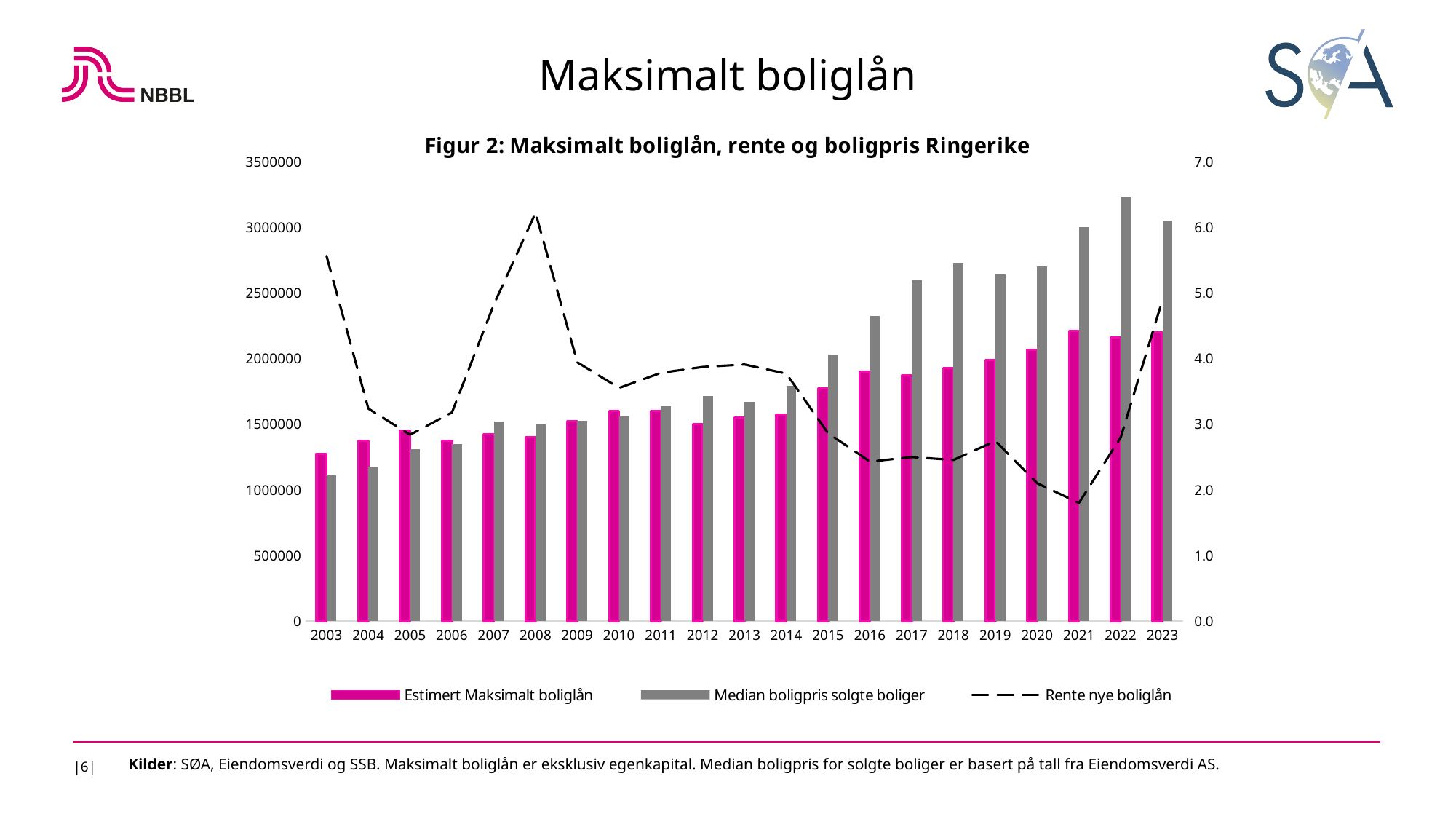
Does Median boligpris solgte boliger generally rise or fall from 2003 to 2023? rise What kind of chart is this? Bar chart combined with a line How many series does the legend list? 3 In which year is Rente nye boliglån highest? 2008 How many years are shown on the x axis? 21 What is the title of the chart? Figur 2: Maksimalt boliglån, rente og boligpris Ringerike In which year is Median boligpris solgte boliger highest? 2022 In which year is Median boligpris solgte boliger lowest? 2003 In 2003, which is larger: Estimert Maksimalt boliglån or Median boligpris solgte boliger? Estimert Maksimalt boliglån In which year is Rente nye boliglån lowest? 2021 Is the value for Rente nye boliglån in 2021 greater or less than 3.0? less Is the value for Median boligpris solgte boliger in 2022 greater or less than 3000000? greater